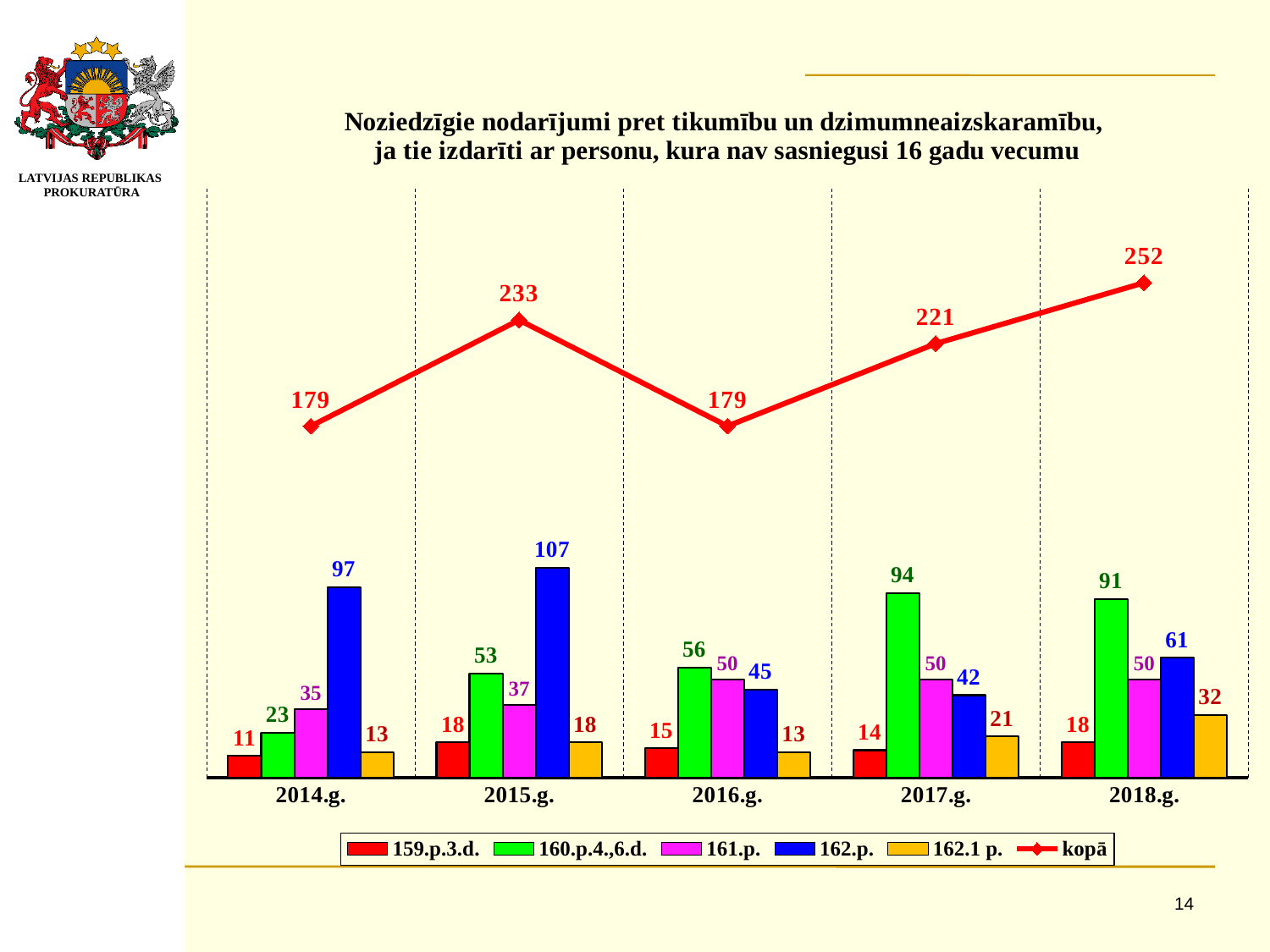
Which series is drawn as a red line with diamond markers? kopā Which is larger in 2016.g.: the value for 161.p. or the value for 162.p.? 161.p. What is the value for 160.p.4.,6.d. in 2017.g.? 94 What is the value of the kopā line for 2018.g.? 252 How many years are shown on the x axis? 5 How many series does the legend list? 6 What kind of chart is shown on the slide? Combined bar and line chart What is the value for 162.p. in 2015.g.? 107 In which year is the value for 159.p.3.d. lowest? 2014.g. What is the value for 162.1 p. in 2018.g.? 32 What is the difference between the kopā values for 2015.g. and 2016.g.? 54 In which year is the kopā line highest? 2018.g.